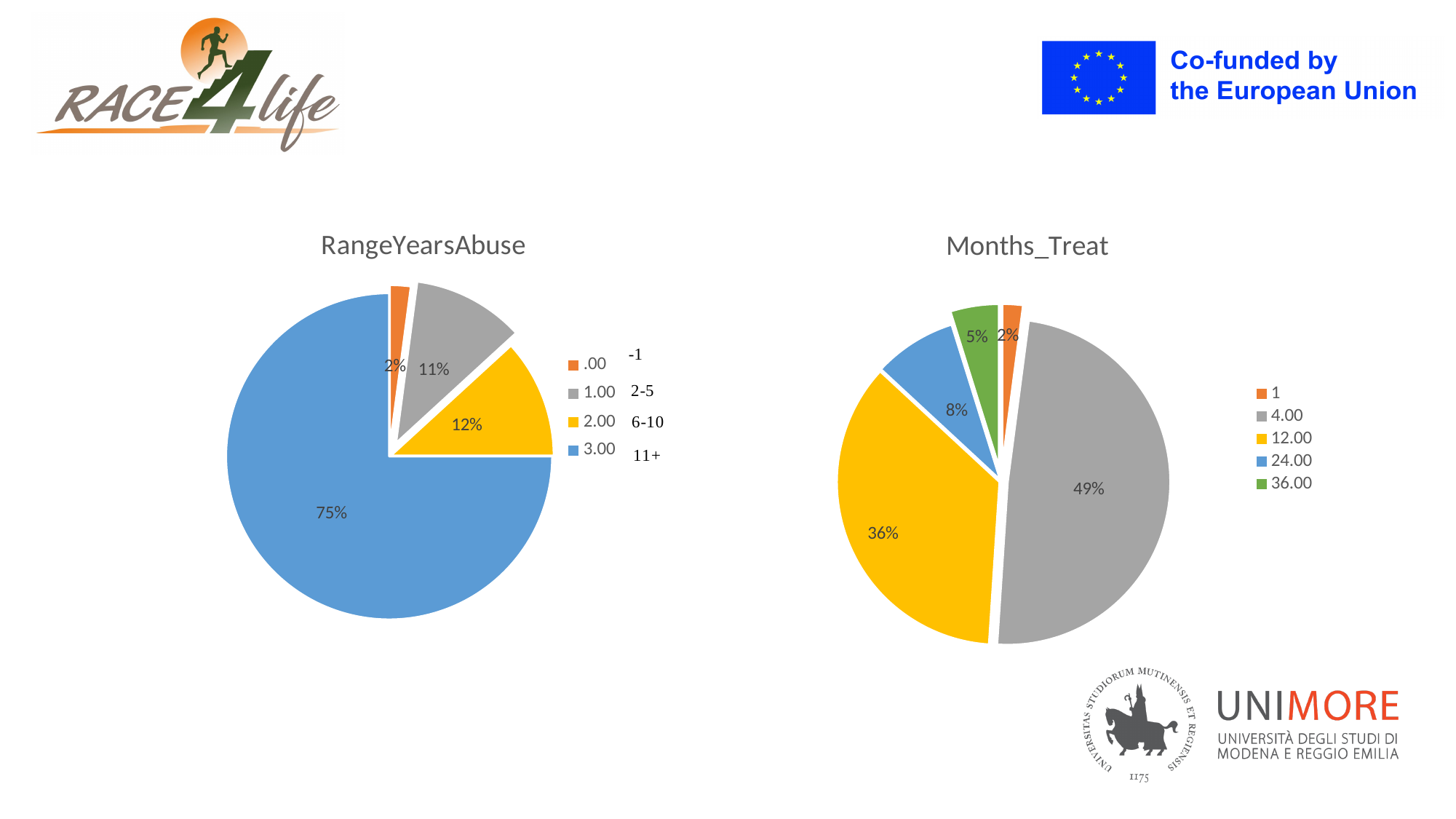
In the RangeYearsAbuse chart, what share of the pie does the 3.00 slice take? 75% In the RangeYearsAbuse chart, which category has the smallest slice? .00 How many entries does the legend of the Months_Treat chart list? 5 In the Months_Treat chart, what is the difference in percentage points between the 4.00 slice and the 12.00 slice? 13% In the Months_Treat chart, which category has the largest slice? 4.00 In the RangeYearsAbuse chart, what is the value shown for the 2.00 slice? 12% What type of chart is the Months_Treat chart? Pie chart In the Months_Treat chart, what is the value shown for the 24.00 slice? 8% In the Months_Treat chart, which is larger, the 12.00 slice or the 36.00 slice? 12.00 In the RangeYearsAbuse chart, what is the difference in percentage points between the 2.00 slice and the 1.00 slice? 1% In the RangeYearsAbuse chart, how many slices does the pie have? 4 In the Months_Treat chart, what share of the pie does the 4.00 slice take? 49%